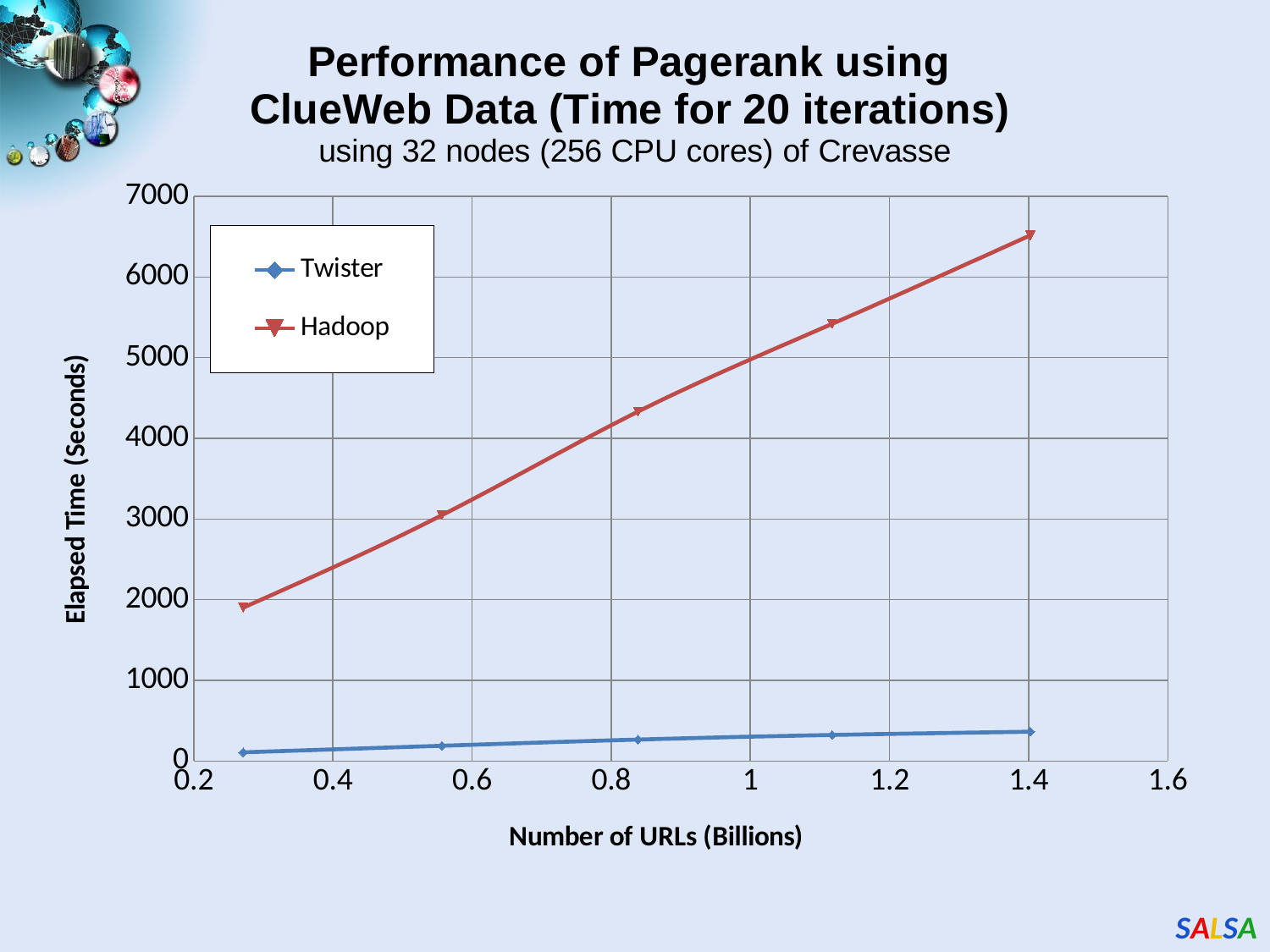
What kind of chart is shown on the slide? line chart Does the elapsed time for Twister rise or fall as the number of URLs increases? rise Is the elapsed time for Hadoop at about 0.84 billion URLs greater or less than 4000 seconds? greater Which two series are listed in the legend? Twister and Hadoop How many series does the legend list? 2 Is the elapsed time for Twister at 1.4 billion URLs greater or less than 1000 seconds? less Which series has the higher elapsed time at 1.4 billion URLs, Twister or Hadoop? Hadoop Does the elapsed time for Hadoop rise or fall as the number of URLs increases? rise What is the label of the x axis? Number of URLs (Billions) Which series has the lower elapsed time across all numbers of URLs? Twister Is the elapsed time for Hadoop at 1.4 billion URLs greater or less than 6000 seconds? greater How many data points are plotted for the Hadoop series? 5